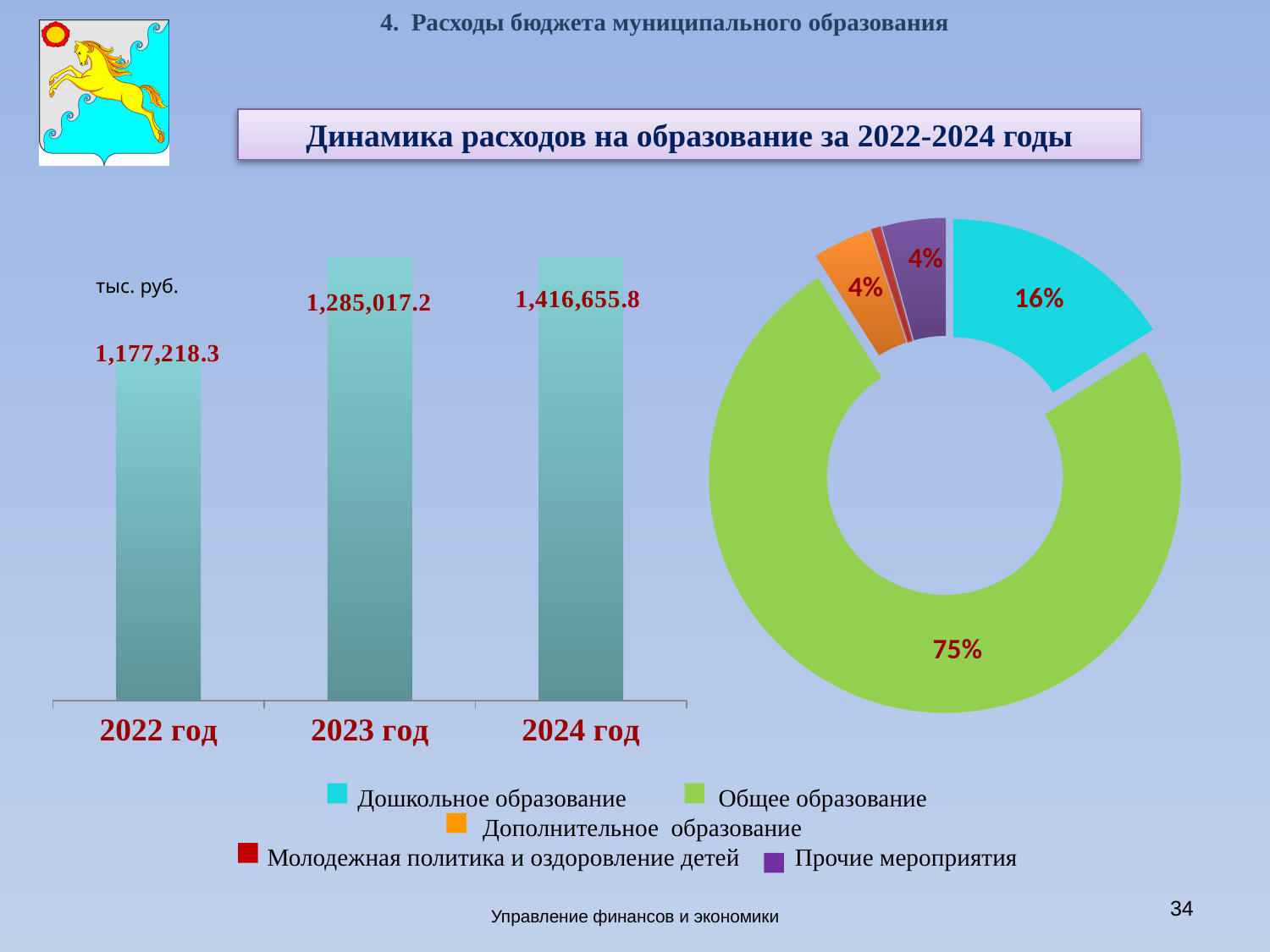
On the bar chart on the left, which year has the highest value? 2024 год On the donut chart on the right, what share does Общее образование have? 75% On the donut chart on the right, what share does Дошкольное образование have? 16% On the bar chart on the left, what is the difference between the values for 2024 год and 2023 год? 131,638.6 What kind of chart is the chart on the left of the slide? bar chart On the donut chart on the right, which category has the largest share? Общее образование On the bar chart on the left, what is the value for 2022 год? 1,177,218.3 On the bar chart on the left, what is the value for 2024 год? 1,416,655.8 How many categories does the legend of the donut chart on the right list? 5 On the bar chart on the left, how many years are shown? 3 On the bar chart on the left, which year has the lowest value? 2022 год On the bar chart on the left, do the values rise or fall from 2022 год to 2024 год? rise